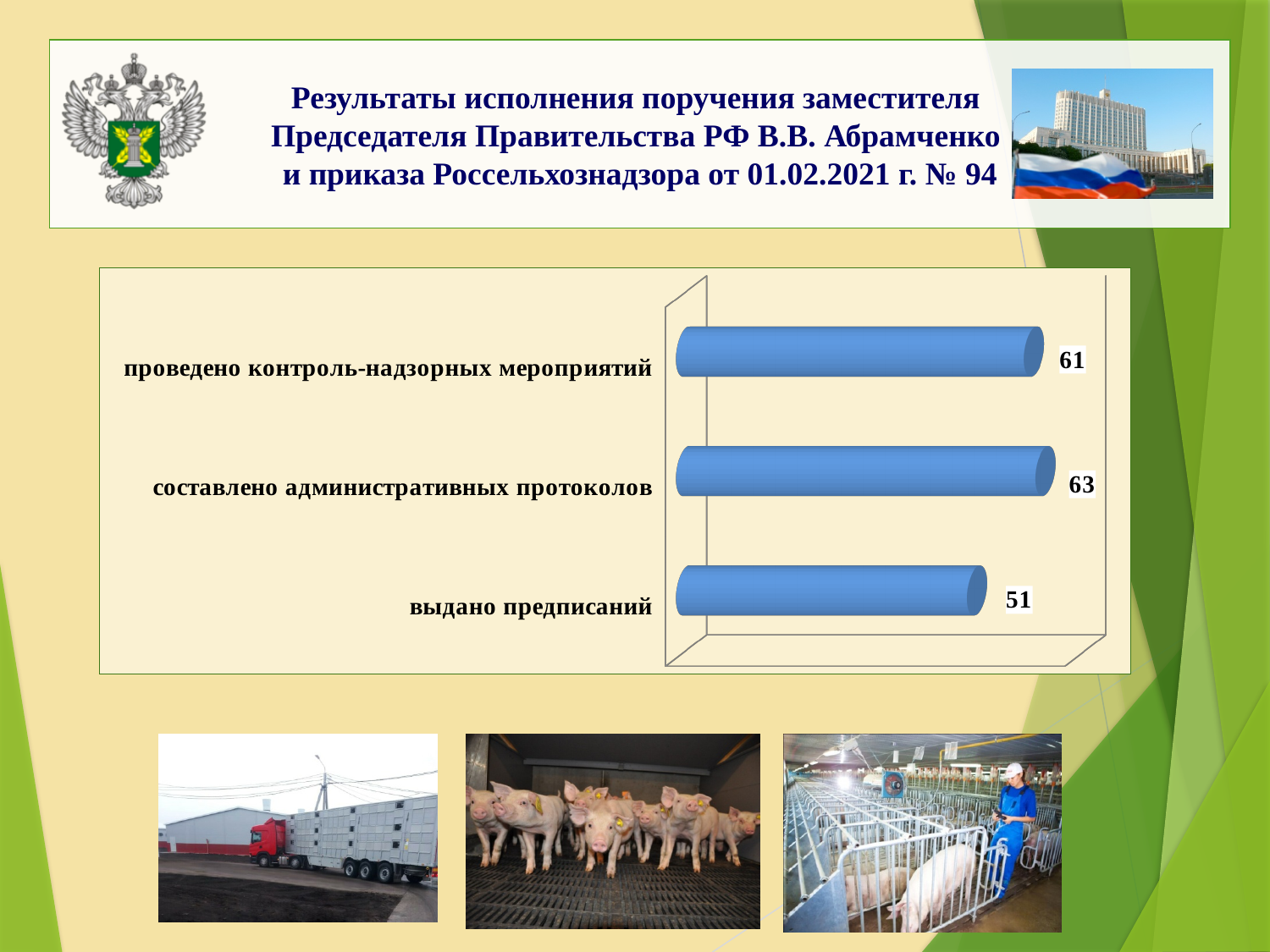
Are the bars in the chart horizontal or vertical? horizontal What is the difference between the values for "составлено административных протоколов" and "выдано предписаний"? 12 What value is shown for "составлено административных протоколов"? 63 What value is shown for "проведено контроль-надзорных мероприятий"? 61 Which category has the highest value? составлено административных протоколов What value is shown for "выдано предписаний"? 51 What is the difference between the values for "проведено контроль-надзорных мероприятий" and "выдано предписаний"? 10 What kind of chart is shown on the slide? bar chart What colour are the bars in the chart? blue Which is larger: the value for "проведено контроль-надзорных мероприятий" or for "выдано предписаний"? проведено контроль-надзорных мероприятий How many categories are shown in the chart? 3 Which category has the lowest value? выдано предписаний